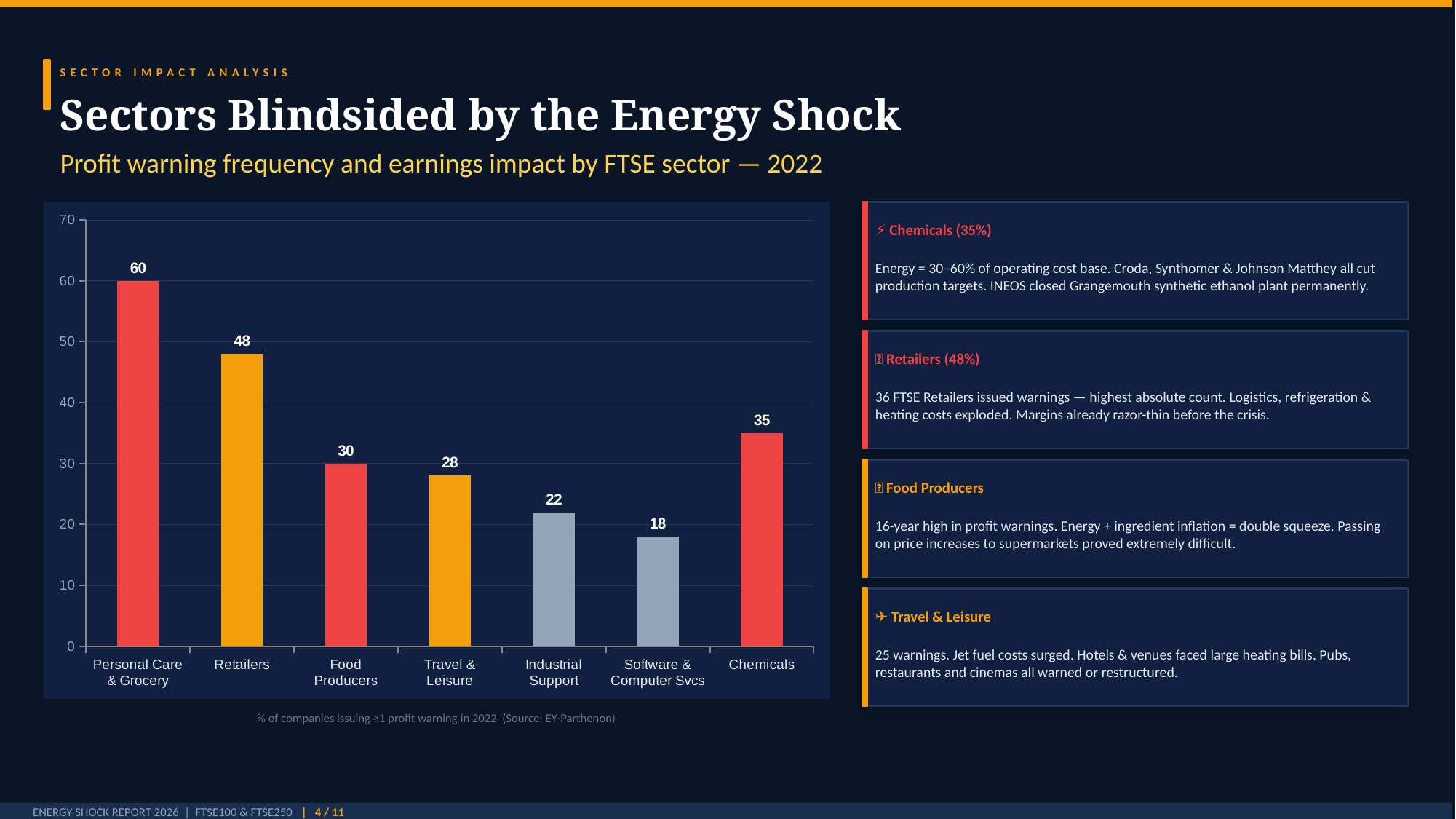
What is the difference between the values for Personal Care & Grocery and Retailers? 12 How many categories are shown on the x axis? 7 What is the caption below the chart describing what the values represent? % of companies issuing ≥1 profit warning in 2022 Which category has the lowest value? Software & Computer Svcs What is the value for Retailers? 48 What is the difference between the values for Chemicals and Industrial Support? 13 Which category has the highest value? Personal Care & Grocery Which is larger, the value for Food Producers or the value for Travel & Leisure? Food Producers Is the value for Chemicals greater or less than 30? greater What is the value for Chemicals? 35 What kind of chart is shown on the slide? bar chart What is the value for Software & Computer Svcs? 18